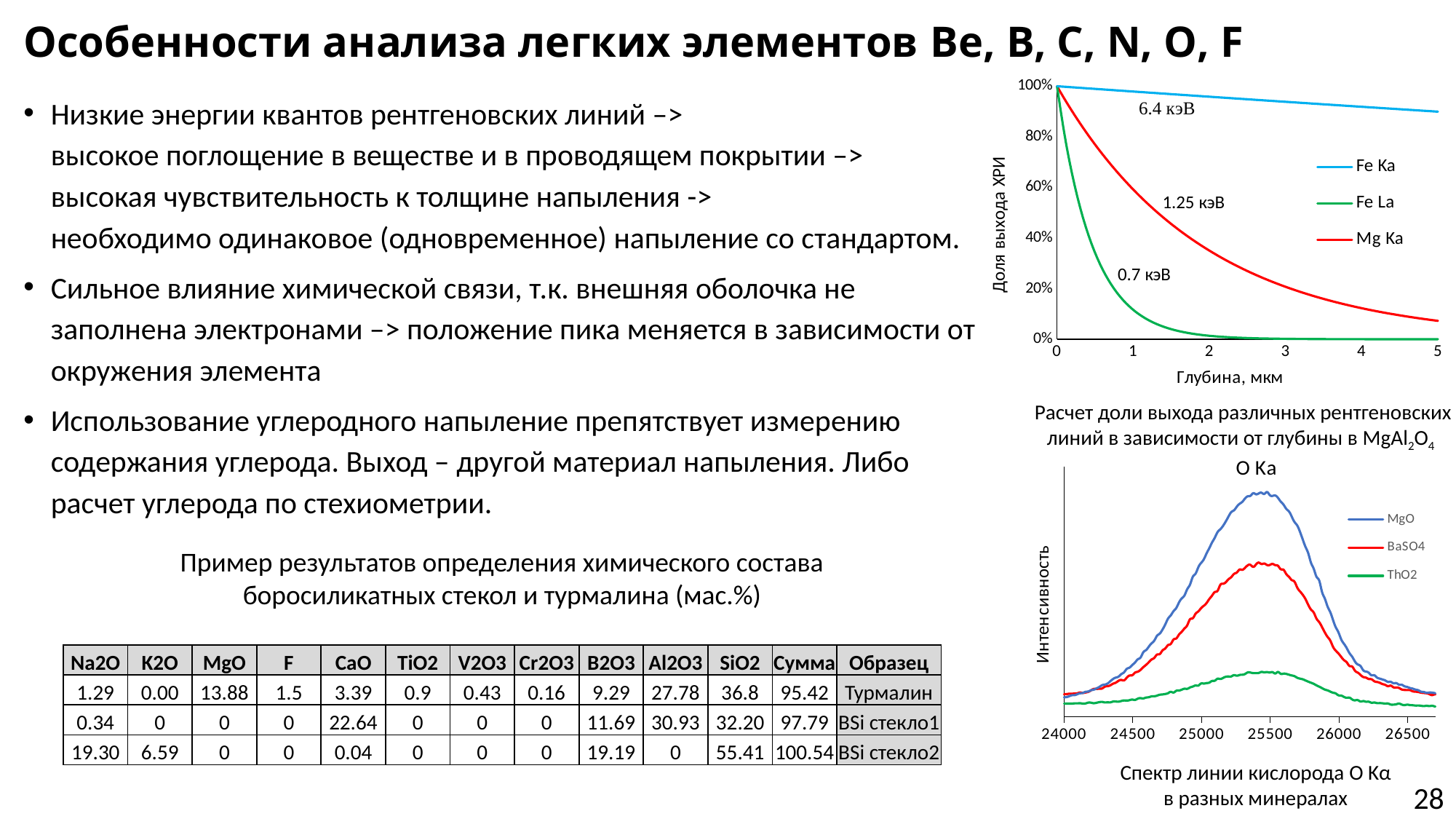
In the top-right chart (Доля выхода ХРИ vs Глубина), at a depth of 2 мкм, which is larger: Mg Ka or Fe La? Mg Ka In the top-right chart (Доля выхода ХРИ vs Глубина), which series are listed in the legend? Fe Ka, Fe La, Mg Ka What kind of chart is the top-right chart showing Доля выхода ХРИ versus Глубина, мкм? line chart In the top-right chart (Доля выхода ХРИ vs Глубина), is the value for Mg Ka at a depth of 1 мкм greater or less than 40%? greater In the top-right chart (Доля выхода ХРИ vs Глубина), which series has the highest value at a depth of 3 мкм? Fe Ka In the top-right chart (Доля выхода ХРИ vs Глубина), is the value for Fe Ka at a depth of 5 мкм greater or less than 80%? greater In the top-right chart (Доля выхода ХРИ vs Глубина), how many series does the legend list? 3 In the bottom-right chart titled O Ka, which series has the lowest peak intensity? ThO2 In the top-right chart (Доля выхода ХРИ vs Глубина), does the Mg Ka curve rise or fall as depth increases? fall In the bottom-right chart titled O Ka, how many series does the legend list? 3 In the top-right chart (Доля выхода ХРИ vs Глубина), is the value for Fe La at a depth of 1 мкм greater or less than 20%? less In the bottom-right chart titled O Ka, which series has the highest peak intensity? MgO